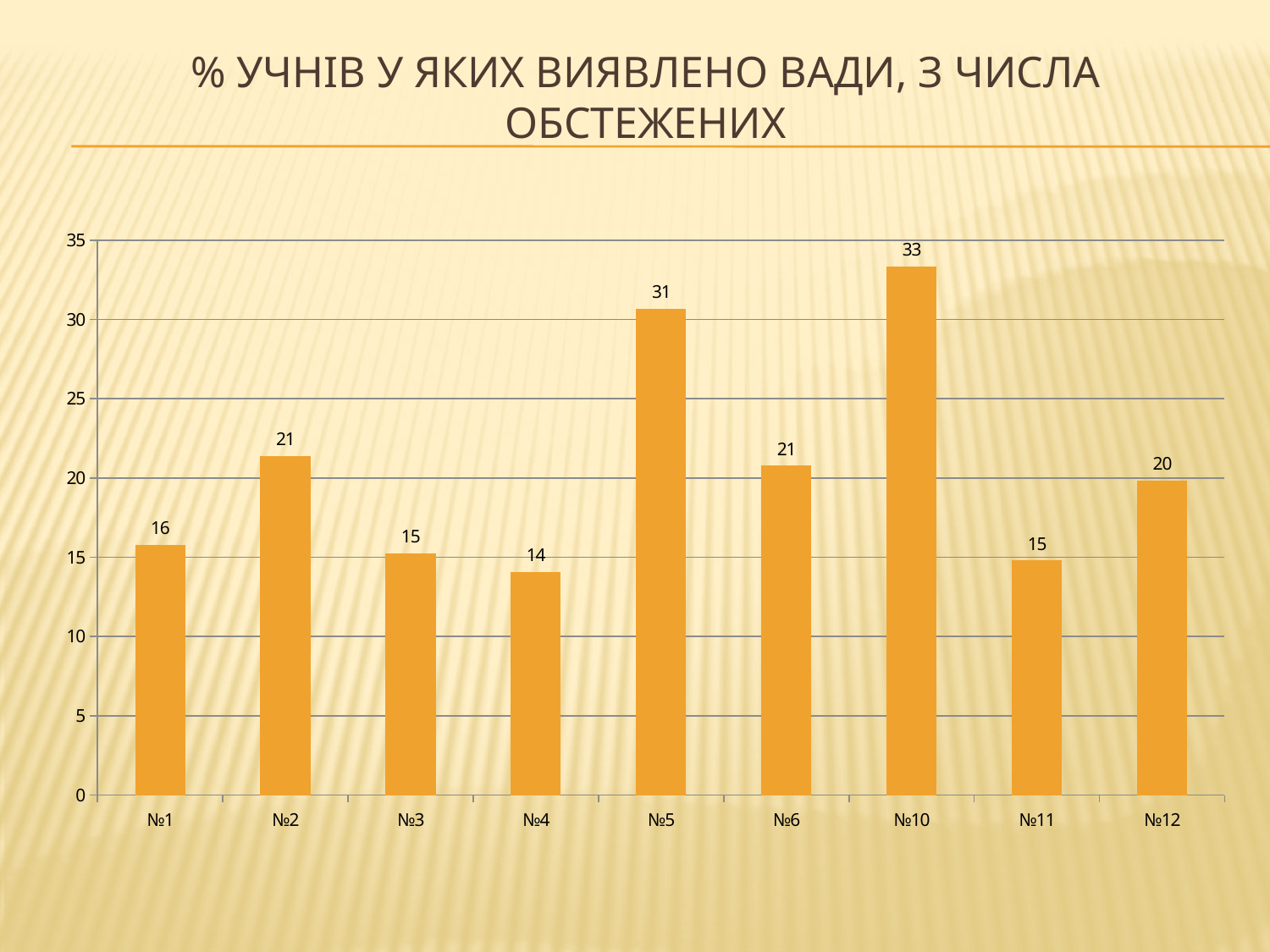
How many categories are shown on the x axis? 9 Is the value for №10 greater or less than 30? greater What is the difference between the values for №2 and №1? 5 What is the difference between the values for №10 and №5? 2 Which is larger, the value for №6 or the value for №11? №6 Which category has the lowest value? №4 What is the title of the chart? % УЧНІВ У ЯКИХ ВИЯВЛЕНО ВАДИ, З ЧИСЛА ОБСТЕЖЕНИХ What is the value for №4? 14 What is the value for №12? 20 Which category has the highest value? №10 What is the value for №5? 31 What kind of chart is shown on the slide? bar chart